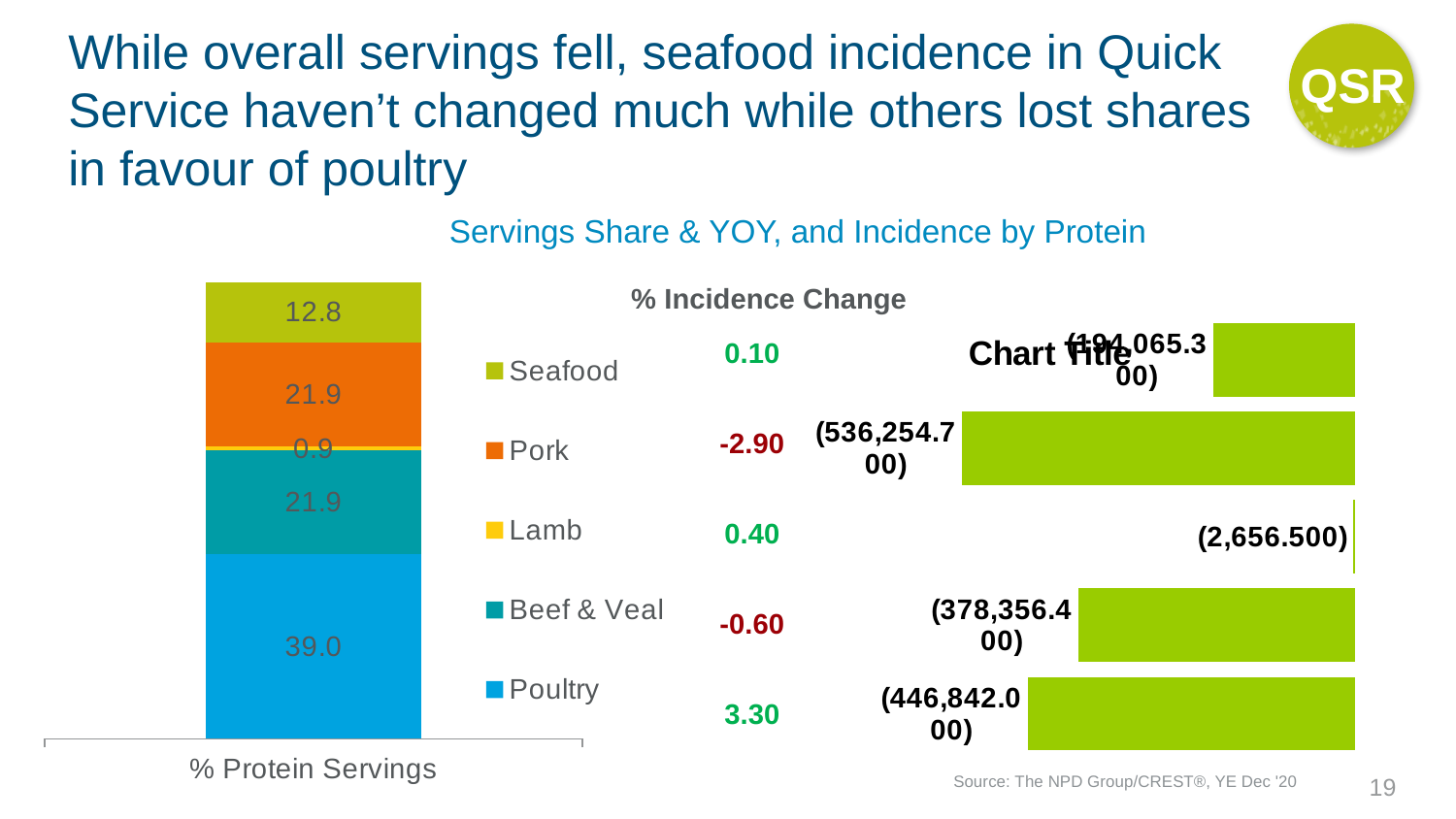
In the % Protein Servings stacked bar, what is the value for Seafood? 12.8 Which protein has the highest % Incidence Change? Poultry How many protein categories does the legend list? 5 In the % Protein Servings stacked bar, what is the total of all the segments? 96.5 In the % Protein Servings stacked bar, which protein has the largest share? Poultry In the % Protein Servings stacked bar, what is the value for Lamb? 0.9 What is the % Incidence Change value for Poultry? 3.30 What is the % Incidence Change value for Pork? -2.90 In the chart on the right titled Chart Title, what is the data label for the Lamb bar? (2,656.500) In the % Protein Servings stacked bar, which protein has the smallest share? Lamb In the % Protein Servings stacked bar, what is the value for Poultry? 39.0 In the % Protein Servings stacked bar, what is the difference between the Poultry and Seafood values? 26.2